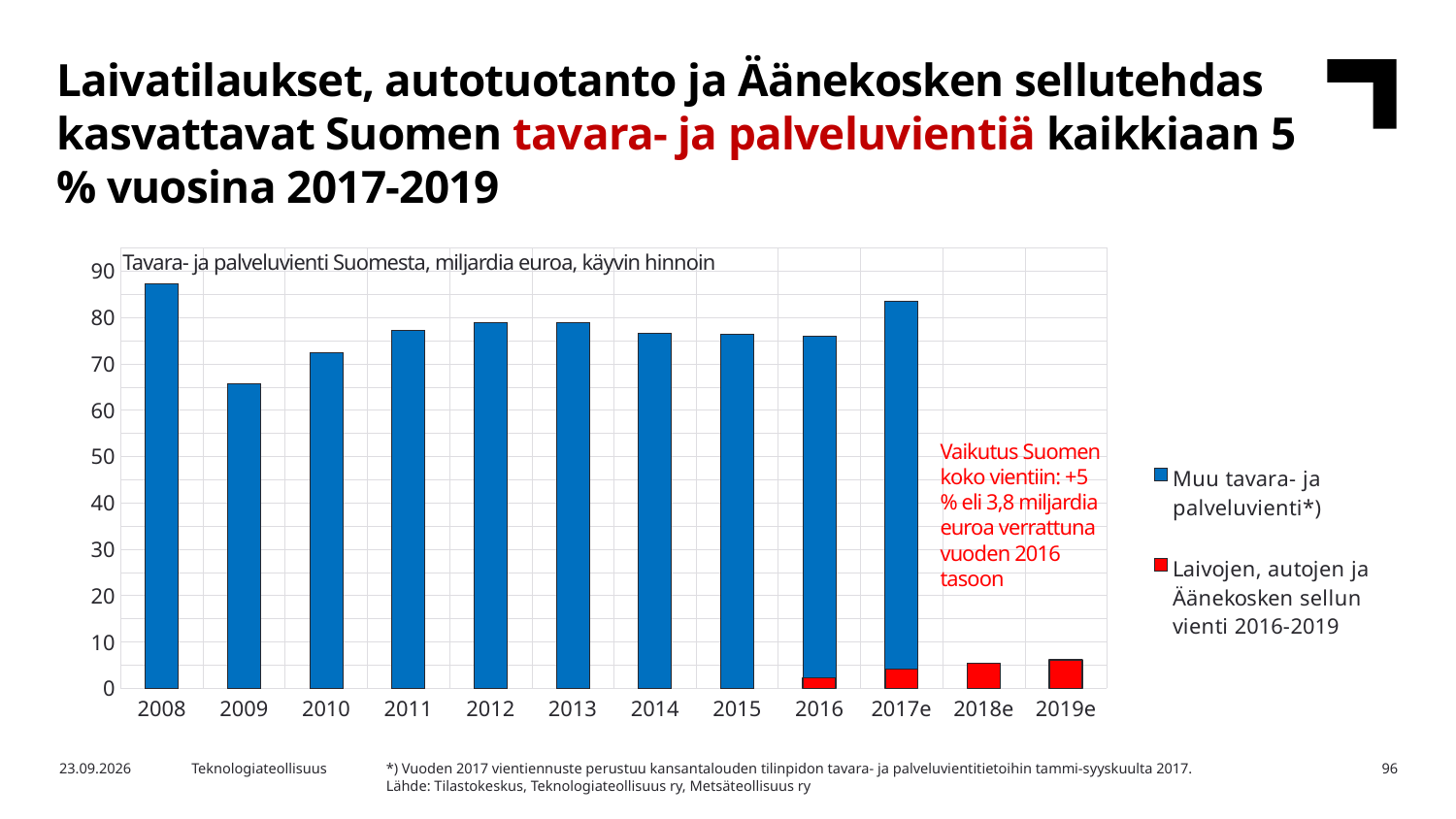
Among the years 2008 to 2017e, which year has the lowest bar for Muu tavara- ja palveluvienti*)? 2009 Which is larger, the bar for 2008 or the bar for 2009? 2008 What is the title of the chart? Tavara- ja palveluvienti Suomesta, miljardia euroa, käyvin hinnoin Is the value for 2010 greater or less than 70? greater Is the value for 2008 greater or less than 80? greater How many series does the legend list? 2 Do the values rise or fall from 2008 to 2009? fall What kind of chart is shown on the slide? bar chart How many years are shown on the x axis? 12 Is the value for 2009 greater or less than 70? less Which year has the highest bar for Muu tavara- ja palveluvienti*)? 2008